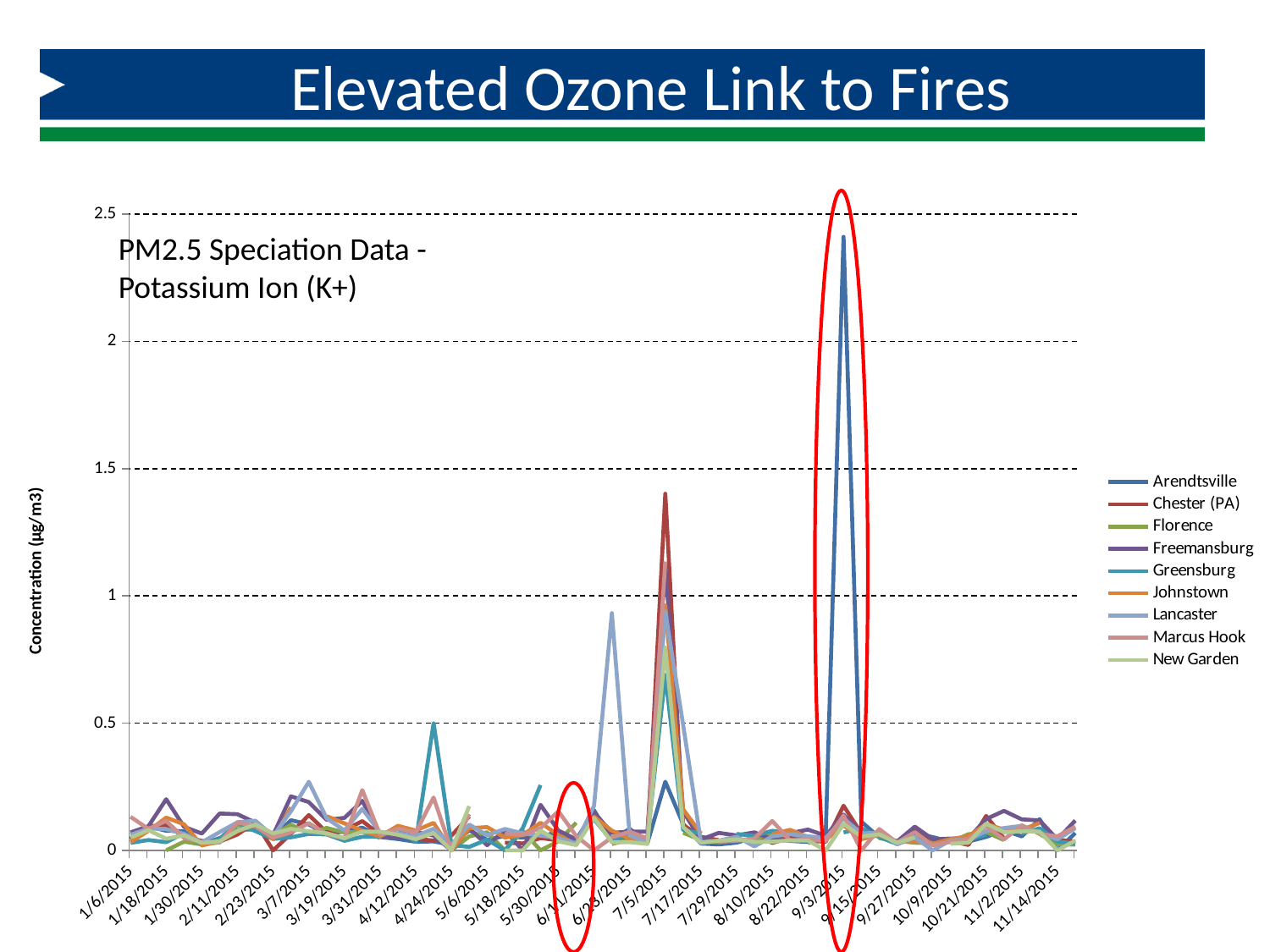
What is the first date label on the horizontal axis? 1/6/2015 What is the title printed inside the chart area? PM2.5 Speciation Data - Potassium Ion (K+) How many series does the legend list? 9 Which series reaches the highest value anywhere on the chart? Arendtsville What is the highest tick value shown on the vertical axis? 2.5 What is the label on the vertical axis? Concentration (µg/m3) Is the peak value for Lancaster near 6/23/2015 greater or less than 0.5? greater Which is larger: the peak of Arendtsville near 9/3/2015 or the peak of Chester (PA) near 7/5/2015? Arendtsville near 9/3/2015 Is the peak value for Arendtsville near 9/3/2015 greater or less than 2? greater Is the peak value for Chester (PA) near 7/5/2015 greater or less than 1.5? less What type of chart is shown on the slide? line chart